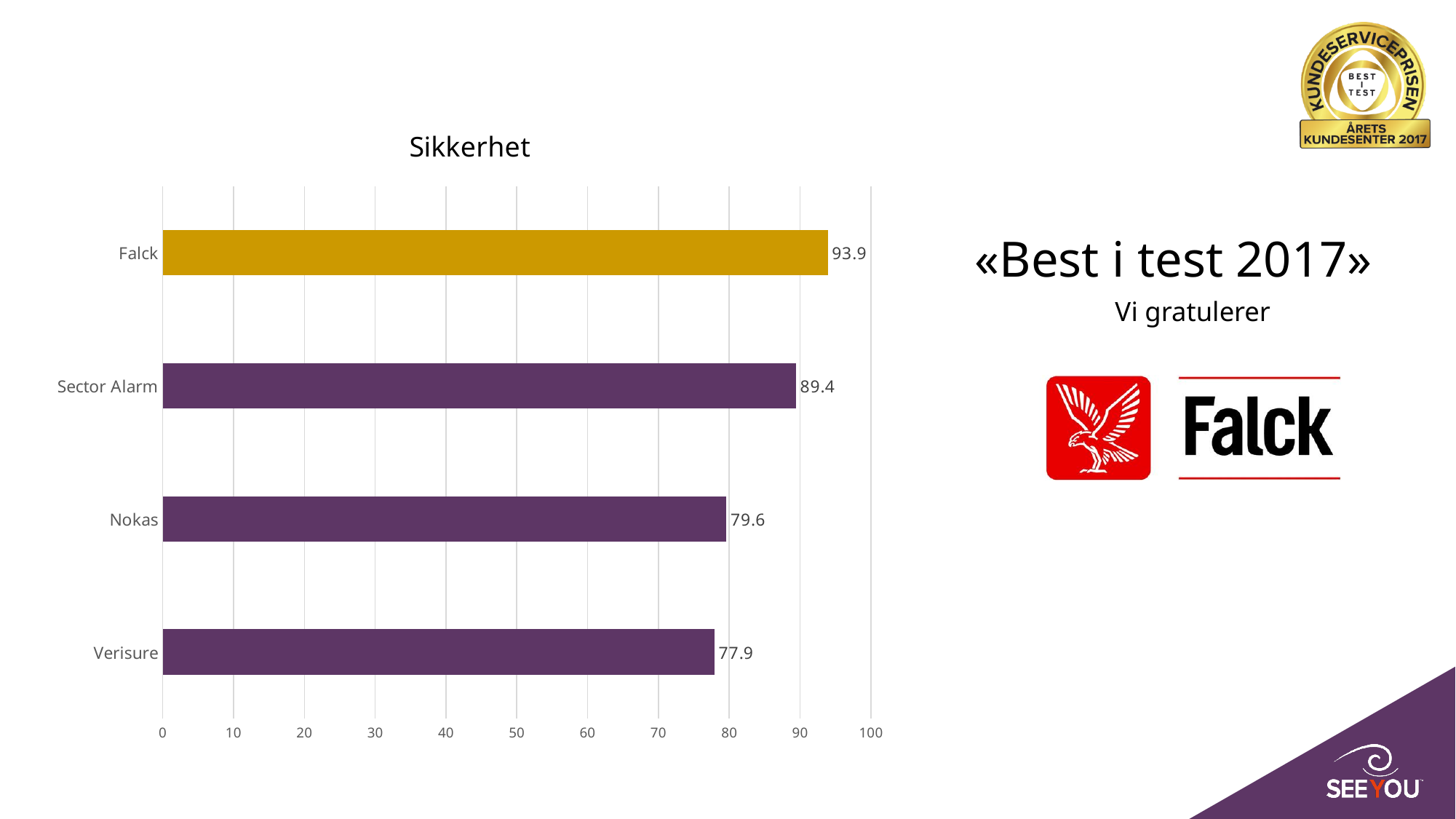
What is the value for Verisure in the Sikkerhet chart? 77.9 What is the value for Nokas in the Sikkerhet chart? 79.6 What is the value for Falck in the Sikkerhet chart? 93.9 Which has a larger value, Sector Alarm or Nokas? Sector Alarm What kind of chart is shown on the slide? Bar chart Which company has the lowest value in the Sikkerhet chart? Verisure Which company has the highest value in the Sikkerhet chart? Falck What is the difference between the values for Nokas and Verisure? 1.7 What is the difference between the values for Falck and Sector Alarm? 4.5 What is the title of the chart? Sikkerhet What is the value for Sector Alarm in the Sikkerhet chart? 89.4 How many companies are shown in the Sikkerhet chart? 4